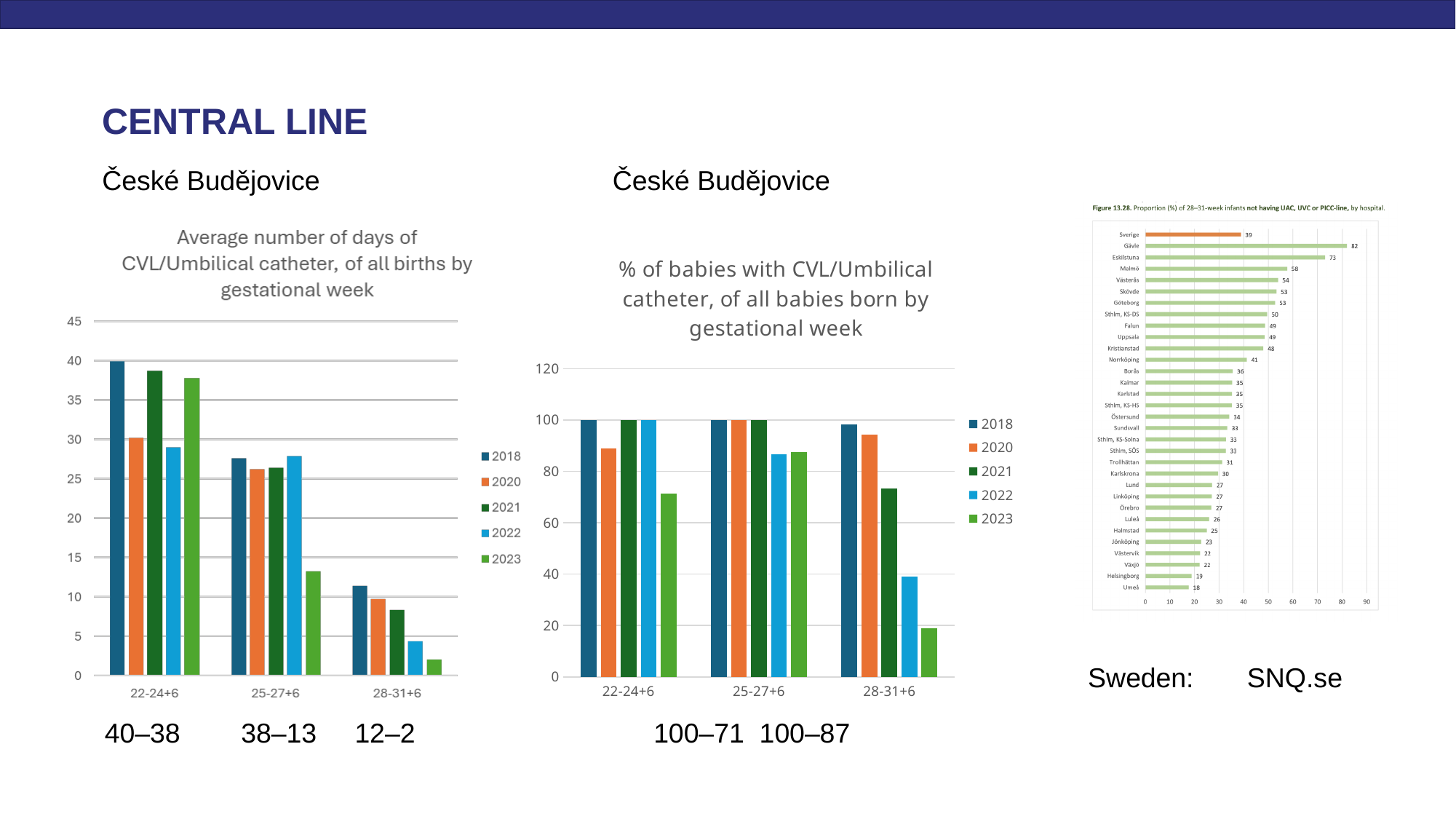
On the left chart (Average number of days of CVL/Umbilical catheter), is the 2023 value for 25-27+6 greater or less than 15? less On the left chart (Average number of days of CVL/Umbilical catheter), do the values for the 2023 series rise or fall from 22-24+6 to 28-31+6? fall On the right chart (Figure 13.28, Sweden), which hospital has the lowest value? Umeå On the left chart (Average number of days of CVL/Umbilical catheter), how many gestational-week categories are shown on the x axis? 3 On the left chart (Average number of days of CVL/Umbilical catheter), how many series does the legend list? 5 On the middle chart (% of babies with CVL/Umbilical catheter), which year has the lowest value for 22-24+6? 2023 On the right chart (Figure 13.28, Sweden), what is the difference between the values for Eskilstuna and Sverige? 34 On the middle chart (% of babies with CVL/Umbilical catheter), is the 2023 value for 28-31+6 greater or less than 40? less On the left chart (Average number of days of CVL/Umbilical catheter), is the 2018 value for 22-24+6 greater or less than 35? greater On the left chart (Average number of days of CVL/Umbilical catheter), which year has the lowest value for 28-31+6? 2023 What kind of chart is the middle chart (% of babies with CVL/Umbilical catheter)? bar chart On the right chart (Figure 13.28, Sweden), what is the value for Gävle? 82